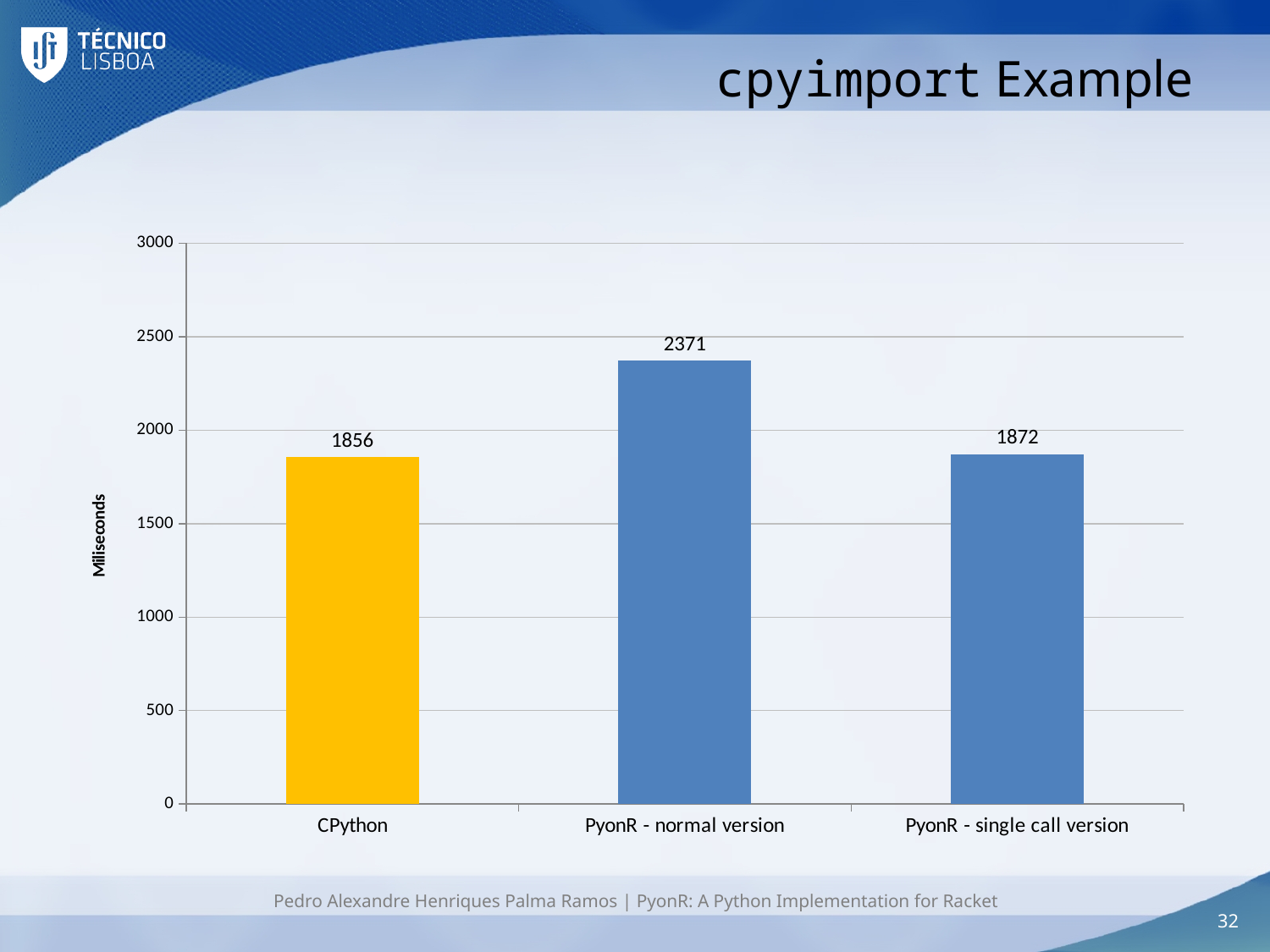
Which category has the highest value? PyonR - normal version How many categories are shown on the x axis? 3 What is the value for PyonR - normal version? 2371 Which is larger, the value for PyonR - normal version or PyonR - single call version? PyonR - normal version What is the value for PyonR - single call version? 1872 Which category has the lowest value? CPython What is the difference between the values for PyonR - single call version and CPython? 16 What is the label of the vertical axis? Miliseconds What is the difference between the values for PyonR - normal version and CPython? 515 What is the value for CPython? 1856 Is the value for PyonR - normal version greater or less than 2000? greater What kind of chart is shown on the slide? bar chart